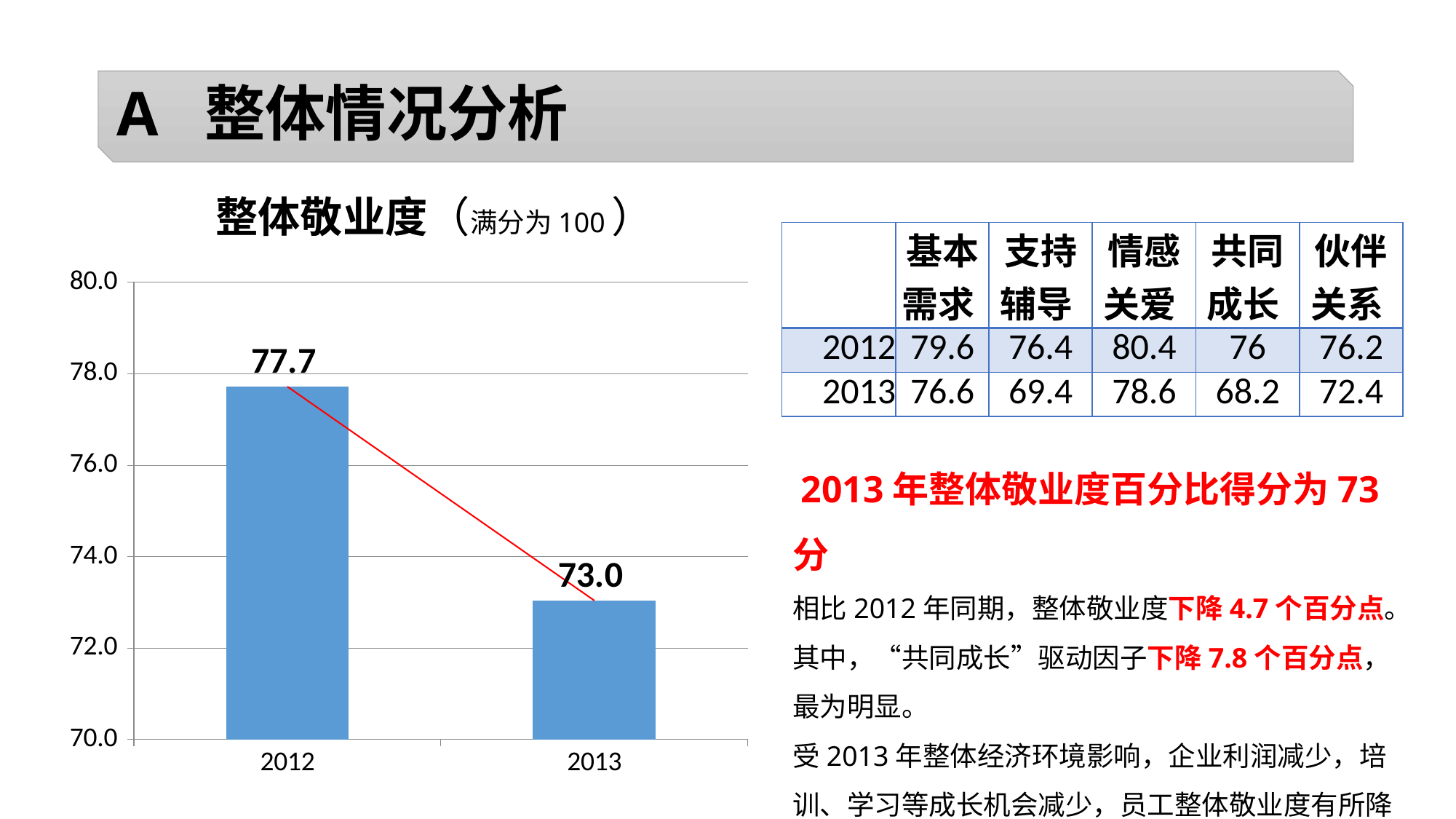
Is the value for 2013 greater or less than 74.0 in the 整体敬业度 chart? less Which year has the higher value in the 整体敬业度 chart? 2012 What is the title of the bar chart on the slide? 整体敬业度（满分为 100） What is the difference between the 2012 and 2013 values in the 整体敬业度 chart? 4.7 What is the value for 2012 in the 整体敬业度 chart? 77.7 Which year has the lower value in the 整体敬业度 chart? 2013 How many bars are shown in the 整体敬业度 chart? 2 Is the value for 2012 greater or less than 76.0 in the 整体敬业度 chart? greater Is the value for 2012 larger or smaller than the value for 2013 in the 整体敬业度 chart? larger Do the values rise or fall from 2012 to 2013 in the 整体敬业度 chart? fall What is the value for 2013 in the 整体敬业度 chart? 73.0 What kind of chart is the 整体敬业度 chart? bar chart